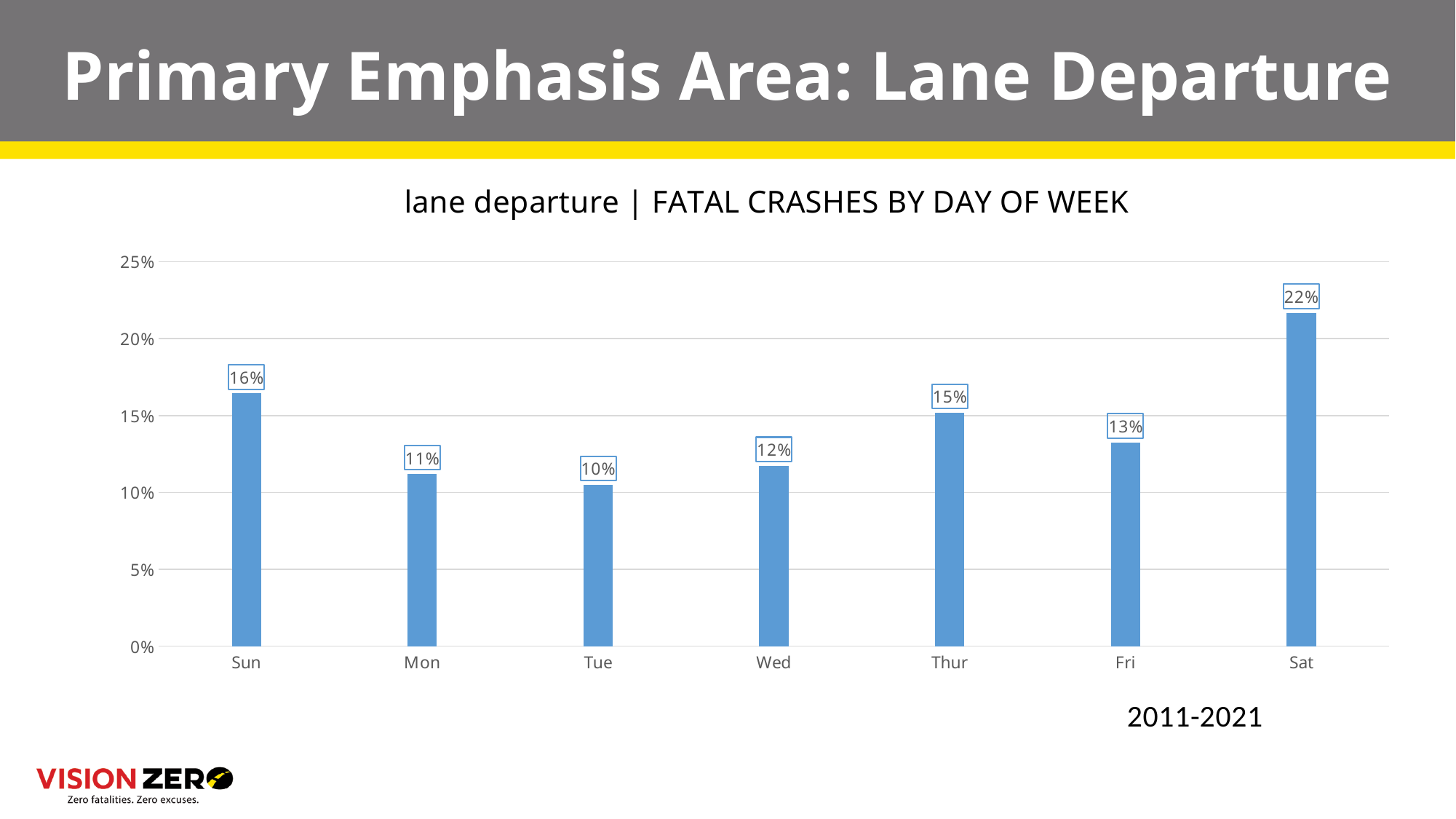
What is the value shown for Tue? 10% What time period is noted below the chart? 2011-2021 Which has a larger value, Sun or Thur? Sun What is the difference between the values for Fri and Mon? 2% What is the difference between the values for Sat and Sun? 6% What kind of chart is shown on the slide? bar chart Which day of the week has the lowest share of fatal crashes? Tue Which day of the week has the highest share of fatal crashes? Sat Is the value for Sat greater or less than 20%? greater What percentage of lane departure fatal crashes occurred on Saturday? 22% How many days of the week are shown on the x axis? 7 What is the value shown for Thur? 15%